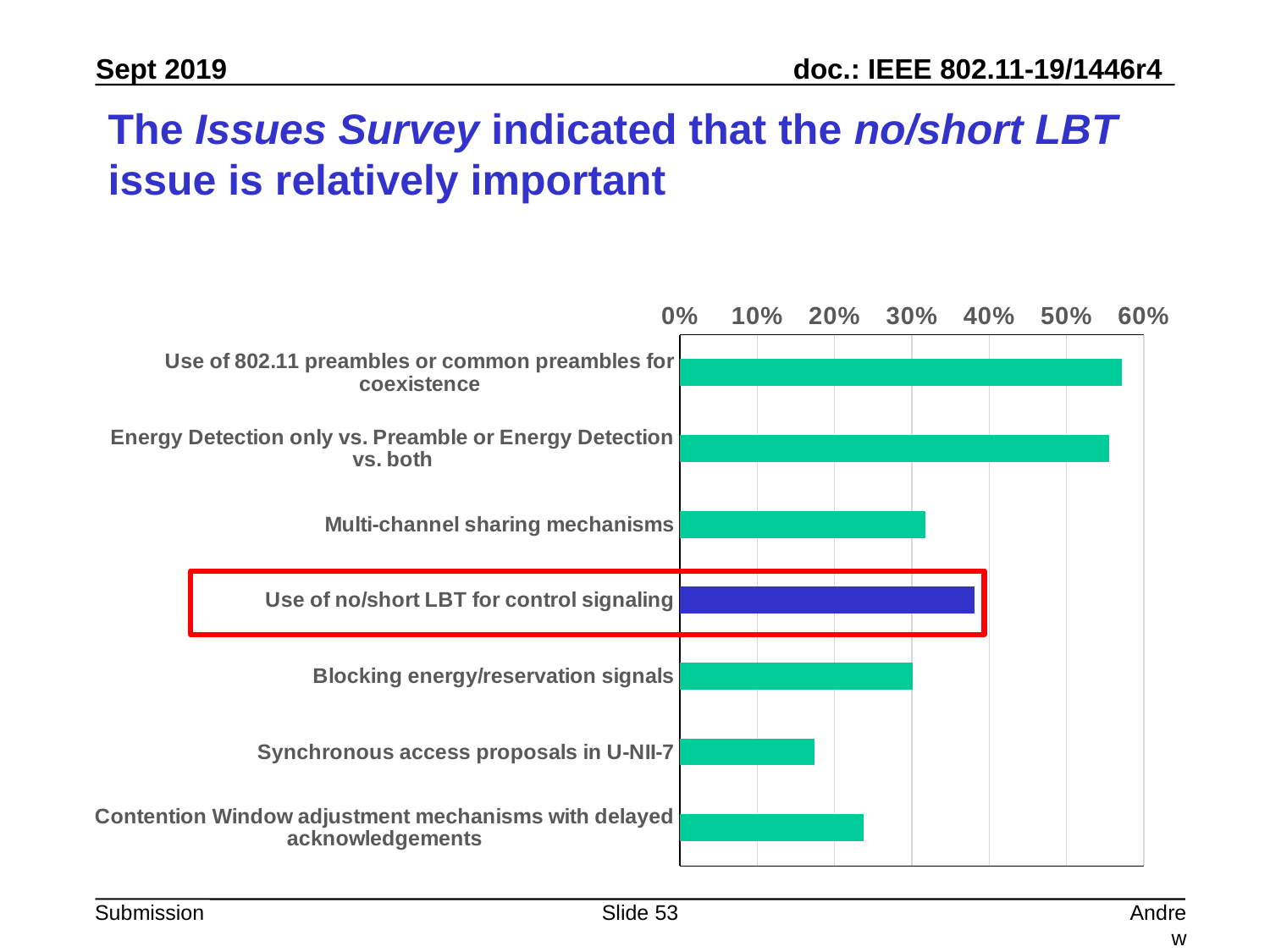
Which category's bar is drawn in a different colour (dark blue) from the others? Use of no/short LBT for control signaling Is the value for Use of no/short LBT for control signaling greater or less than 30%? greater How many categories (bars) does the chart show? 7 Which has the larger value: Multi-channel sharing mechanisms or Contention Window adjustment mechanisms with delayed acknowledgements? Multi-channel sharing mechanisms Is the value for Contention Window adjustment mechanisms with delayed acknowledgements greater or less than 30%? less Which has the larger value: Use of no/short LBT for control signaling or Blocking energy/reservation signals? Use of no/short LBT for control signaling Is the value for Synchronous access proposals in U-NII-7 greater or less than 20%? less What kind of chart is shown on the slide? bar chart Which category has the lowest value in the chart? Synchronous access proposals in U-NII-7 What is the highest value shown on the chart's percentage axis? 60%